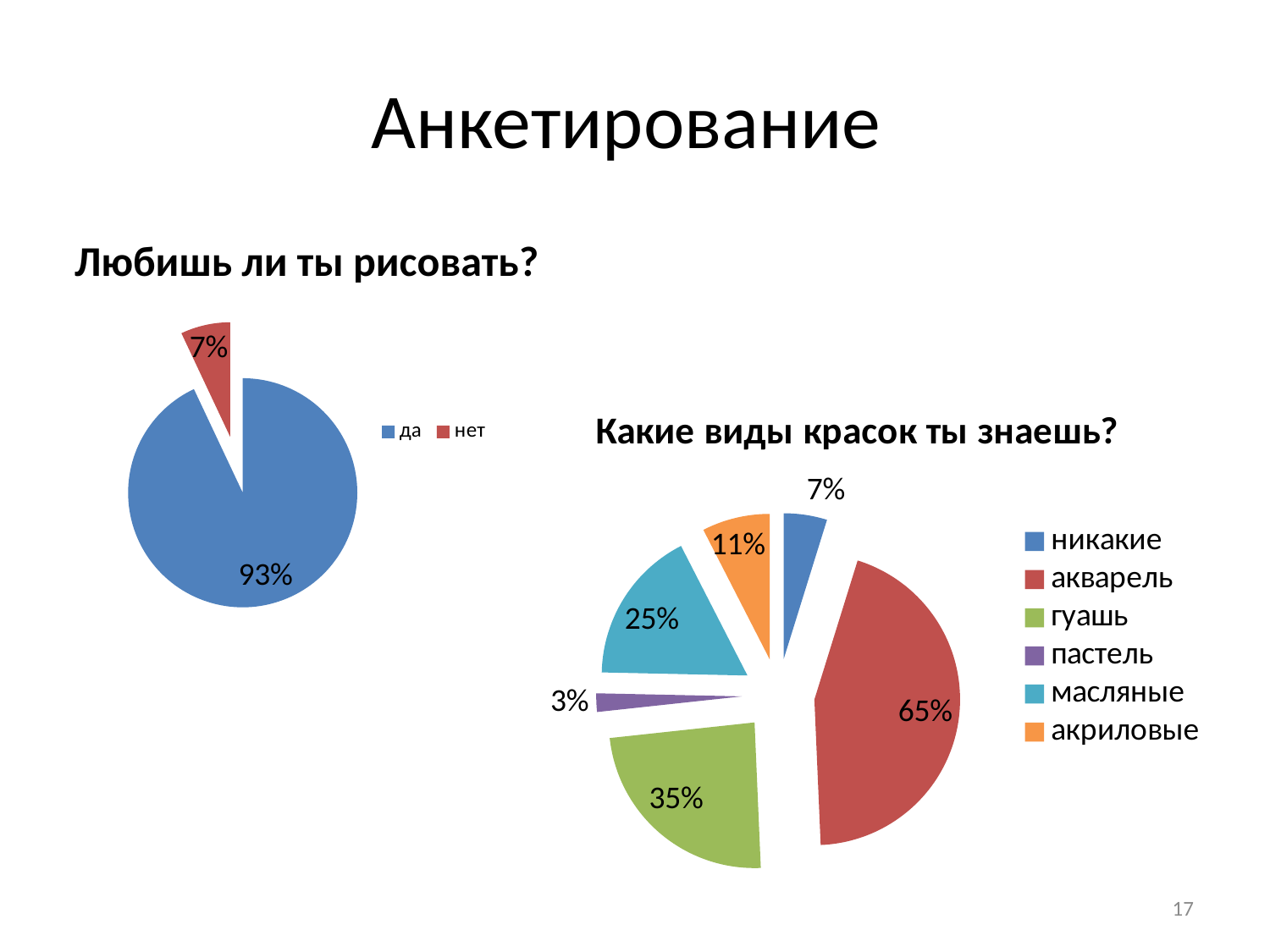
In the chart 'Какие виды красок ты знаешь?', what is the value for 'масляные'? 25% What kind of chart is 'Любишь ли ты рисовать?'? Pie chart In the chart 'Любишь ли ты рисовать?', what percentage answered 'да'? 93% In the chart 'Какие виды красок ты знаешь?', which category has the highest value? акварель In the chart 'Какие виды красок ты знаешь?', what is the difference between 'акварель' and 'гуашь'? 30% In the chart 'Какие виды красок ты знаешь?', what is the value for 'гуашь'? 35% In the chart 'Любишь ли ты рисовать?', what percentage answered 'нет'? 7% How many categories does the legend of the chart 'Какие виды красок ты знаешь?' list? 6 How many entries does the legend of the chart 'Любишь ли ты рисовать?' list? 2 In the chart 'Какие виды красок ты знаешь?', which is larger: 'акриловые' or 'никакие'? акриловые In the chart 'Какие виды красок ты знаешь?', what is the value for 'акварель'? 65% In the chart 'Какие виды красок ты знаешь?', which category has the lowest value? пастель